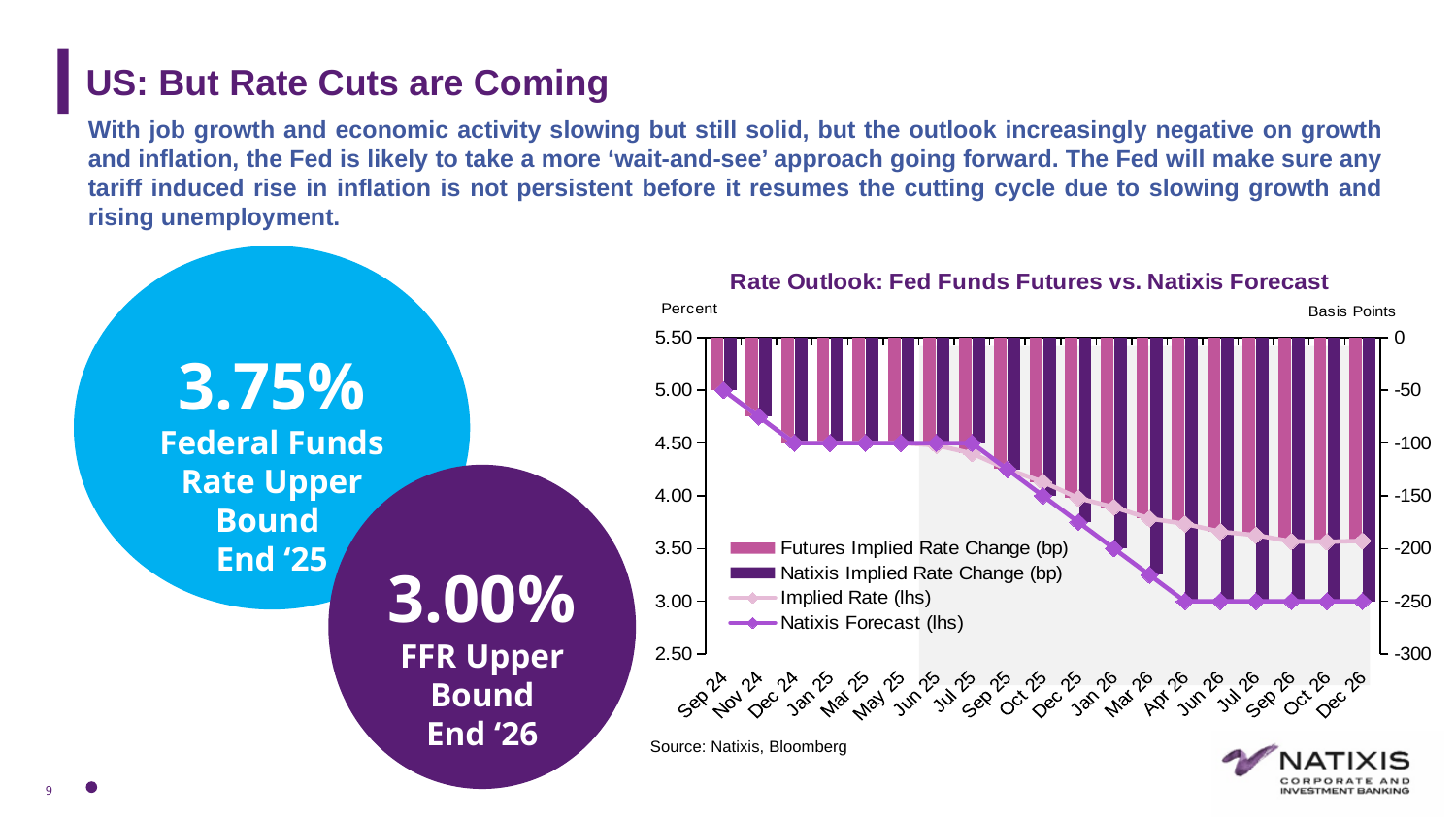
What is the Natixis Forecast (lhs) value at Dec 26? 3.00 Does the Natixis Forecast (lhs) line rise or fall from Sep 24 to Dec 26? Fall At Dec 26, which is higher: the Implied Rate (lhs) or the Natixis Forecast (lhs)? Implied Rate (lhs) What is the label of the left-hand vertical axis of the chart? Percent What kind of chart is shown on the slide? Combined bar and line chart What is the title of the chart on the slide? Rate Outlook: Fed Funds Futures vs. Natixis Forecast How many series does the chart's legend list? 4 Is the Implied Rate (lhs) value at Dec 26 greater or less than 4.00? less How many date labels are shown along the x axis of the chart? 19 What is the Natixis Forecast (lhs) value at Jan 25? 4.50 Is the Natixis Forecast (lhs) value at Mar 26 greater or less than 3.50? less What is the Natixis Forecast (lhs) value at Sep 24? 5.00